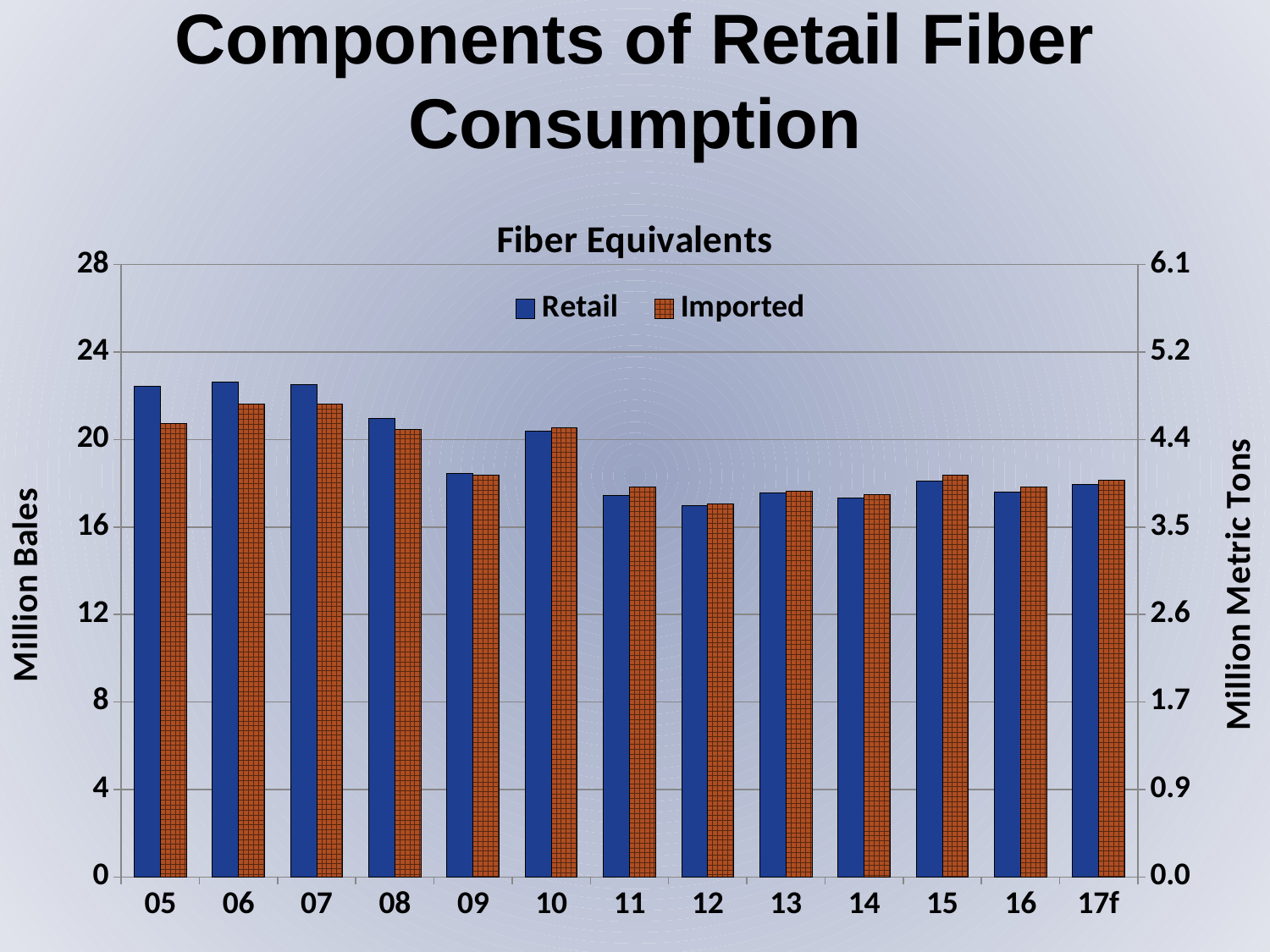
Is the Retail value for 09 greater or less than 20 million bales? less How many year categories are shown on the x axis? 13 Is the Imported value for 06 greater or less than 20 million bales? greater In 05, which is larger, Retail or Imported? Retail What kind of chart is shown on the slide? bar chart How many series does the legend list? 2 Which year has the lowest Retail value? 12 Do the Retail values generally rise or fall from 05 to 12? fall Is the Retail value for 12 greater or less than 20 million bales? less In 11, which is larger, Retail or Imported? Imported What is the label on the left vertical axis? Million Bales